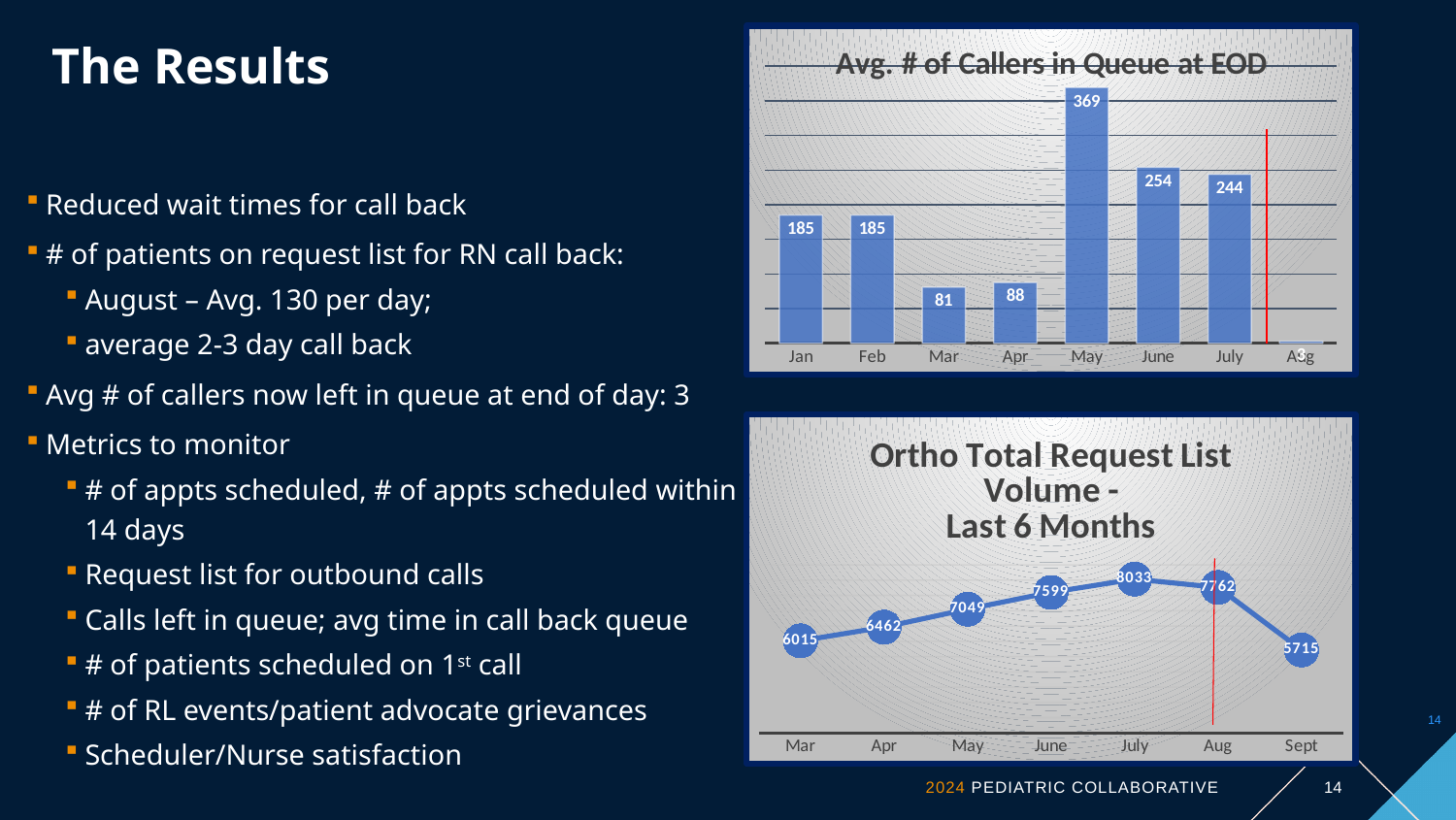
In the 'Ortho Total Request List Volume - Last 6 Months' chart, what is the value for Sept? 5715 In the 'Ortho Total Request List Volume - Last 6 Months' chart, do the values rise or fall from Mar to July? Rise In the 'Avg. # of Callers in Queue at EOD' chart, which month has the highest value? May In the 'Ortho Total Request List Volume - Last 6 Months' chart, what is the value for July? 8033 In the 'Avg. # of Callers in Queue at EOD' chart, what is the value for Mar? 81 In the 'Ortho Total Request List Volume - Last 6 Months' chart, which month has the lowest value? Sept How many months are shown on the x axis of the 'Avg. # of Callers in Queue at EOD' chart? 8 In the 'Avg. # of Callers in Queue at EOD' chart, which is larger, the value for Apr or the value for Mar? Apr What kind of chart is 'Avg. # of Callers in Queue at EOD'? Bar chart In the 'Ortho Total Request List Volume - Last 6 Months' chart, what is the difference between the values for Aug and Sept? 2047 In the 'Avg. # of Callers in Queue at EOD' chart, what is the value for May? 369 In the 'Avg. # of Callers in Queue at EOD' chart, what is the difference between the values for June and July? 10